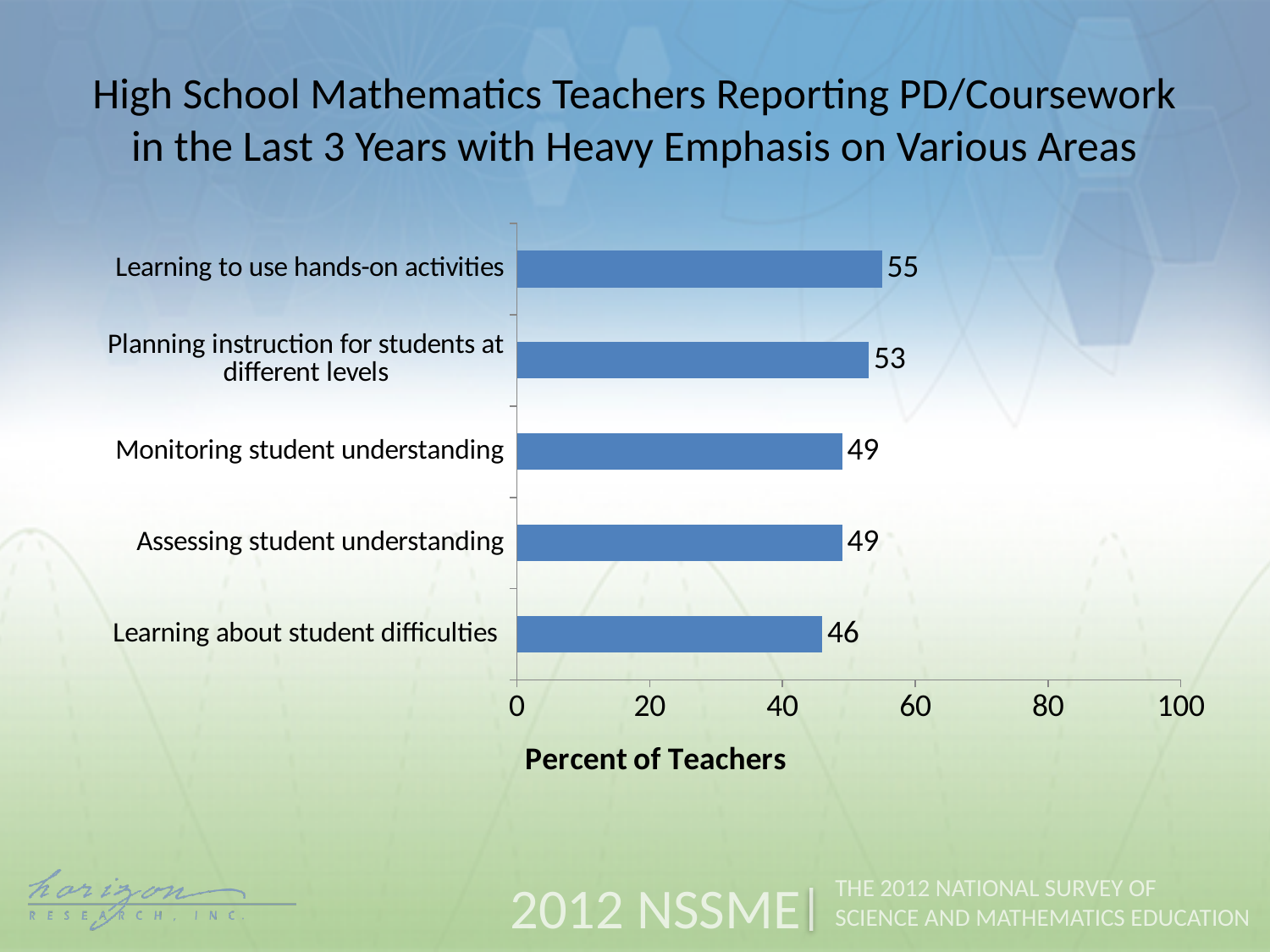
What is the value for 'Learning about student difficulties'? 46 What type of chart is shown on the slide? Bar chart What is the value for 'Monitoring student understanding'? 49 Which is larger: the value for 'Planning instruction for students at different levels' or 'Assessing student understanding'? Planning instruction for students at different levels Which area has the lowest percent of teachers? Learning about student difficulties What is the difference between the values for 'Learning to use hands-on activities' and 'Learning about student difficulties'? 9 What percent of teachers reported heavy emphasis on learning to use hands-on activities? 55 How many areas (bars) are shown in the chart? 5 What is the value for 'Planning instruction for students at different levels'? 53 Is the value for 'Learning about student difficulties' greater or less than 40? greater Which area has the highest percent of teachers? Learning to use hands-on activities What is the label of the horizontal axis? Percent of Teachers